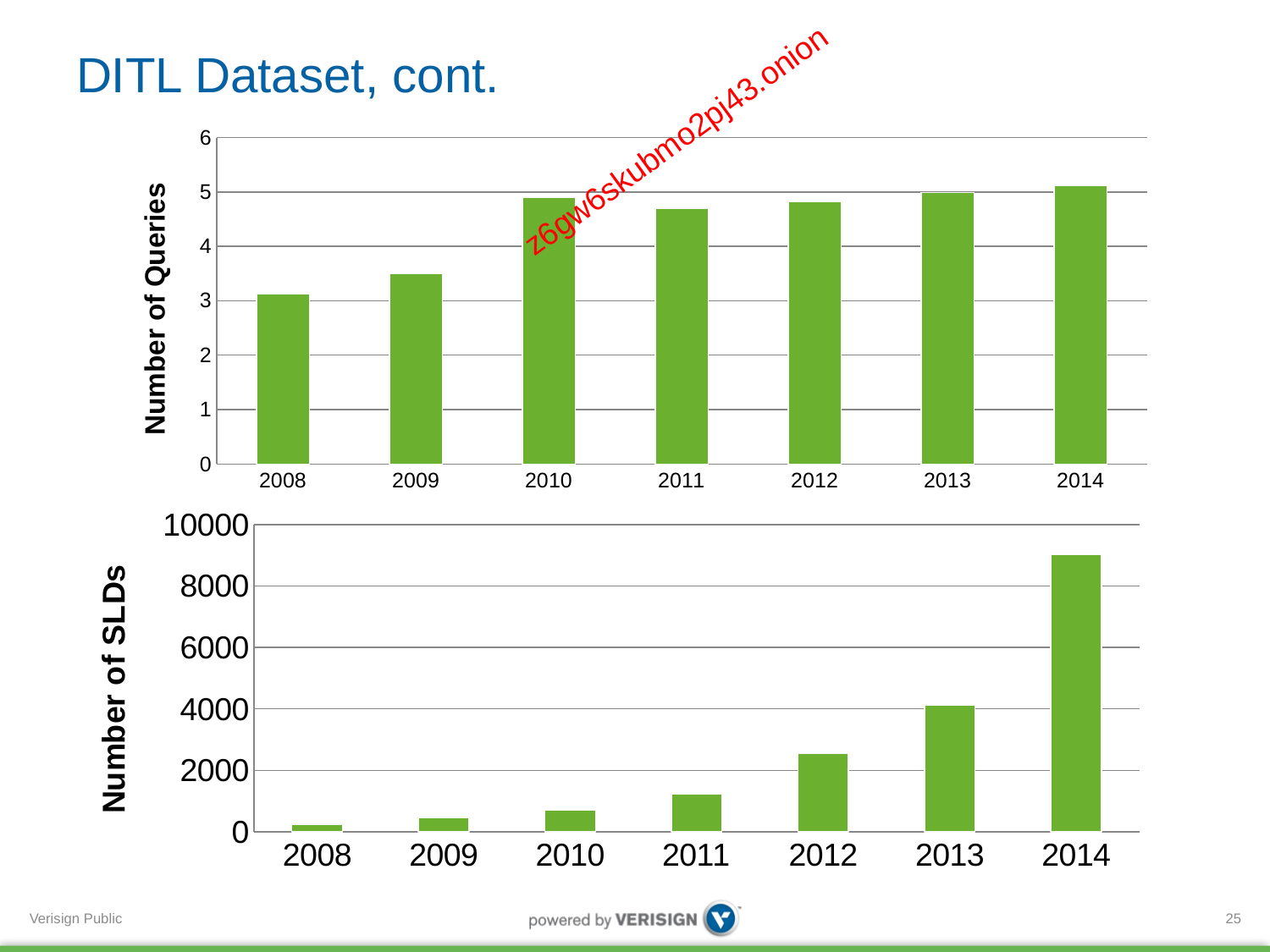
What is the y-axis label of the bottom chart? Number of SLDs In the bottom chart (Number of SLDs), which year has the highest value? 2014 What kind of chart is the top chart labelled "Number of Queries"? bar chart In the top chart (Number of Queries), is the value for 2010 greater or less than 4? greater In the bottom chart (Number of SLDs), do the values rise or fall from 2008 to 2014? rise In the top chart (Number of Queries), how many years are shown on the x axis? 7 In the top chart (Number of Queries), which year has the lowest value? 2008 In the top chart (Number of Queries), which is larger, the value for 2009 or the value for 2011? 2011 In the bottom chart (Number of SLDs), which year has the lowest value? 2008 In the bottom chart (Number of SLDs), is the value for 2013 greater or less than 6000? less In the top chart (Number of Queries), is the value for 2008 greater or less than 4? less